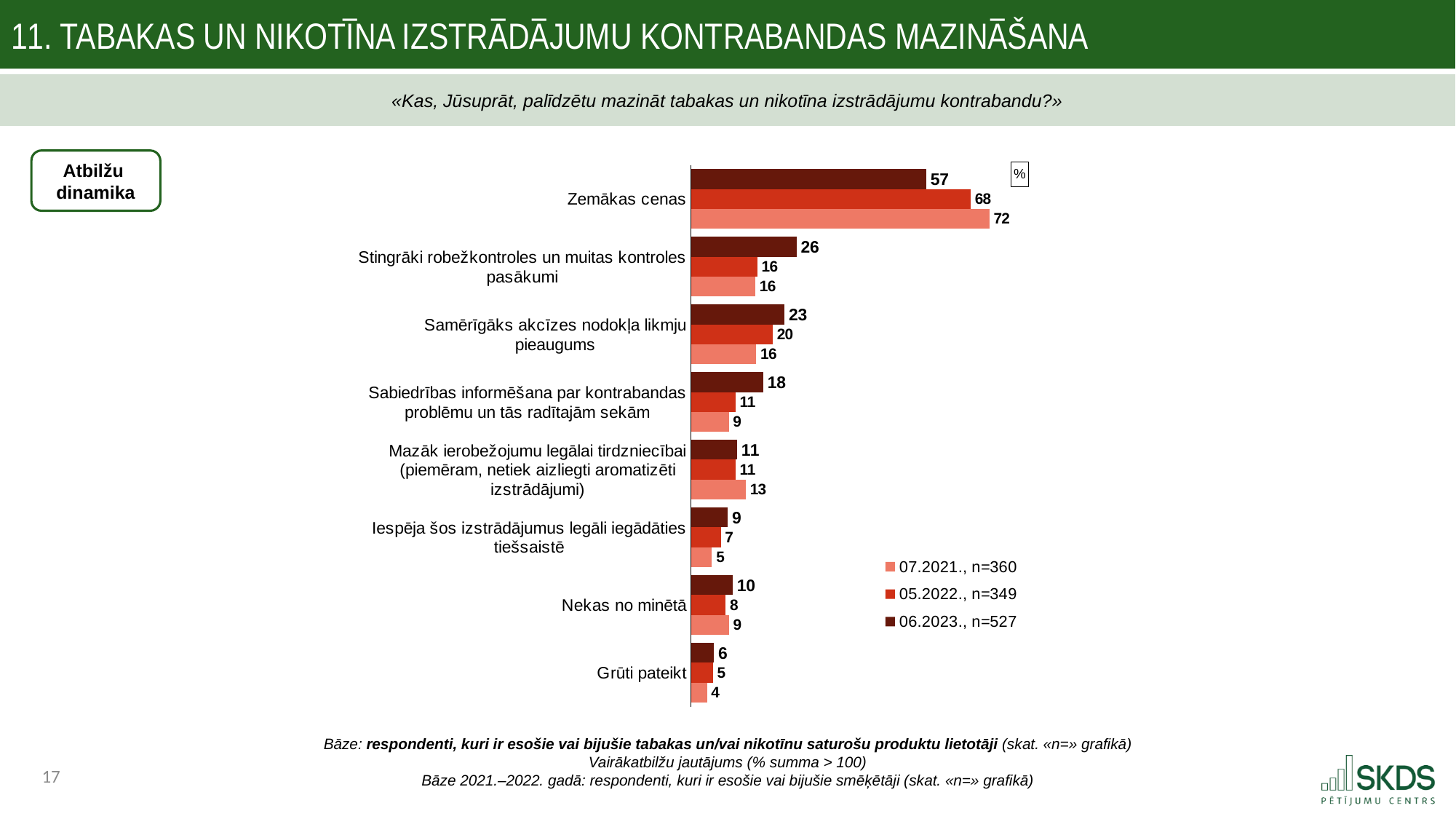
Which category has the lowest value in the 05.2022., n=349 series? Grūti pateikt How many series does the legend list? 3 What is the value for "Zemākas cenas" in the 07.2021., n=360 series? 72 What is the difference between the 07.2021., n=360 and 06.2023., n=527 values for "Zemākas cenas"? 15 What is the value for "Samērīgāks akcīzes nodokļa likmju pieaugums" in the 05.2022., n=349 series? 20 What is the value for "Zemākas cenas" in the 06.2023., n=527 series? 57 For "Stingrāki robežkontroles un muitas kontroles pasākumi", which is larger: the 06.2023., n=527 value or the 05.2022., n=349 value? 06.2023., n=527 What is the sample size (n) shown in the legend for the 06.2023. series? n=527 What kind of chart is shown on the slide? Bar chart Which category has the highest value in the 06.2023., n=527 series? Zemākas cenas What is the value for "Grūti pateikt" in the 07.2021., n=360 series? 4 How many categories are shown on the chart? 8